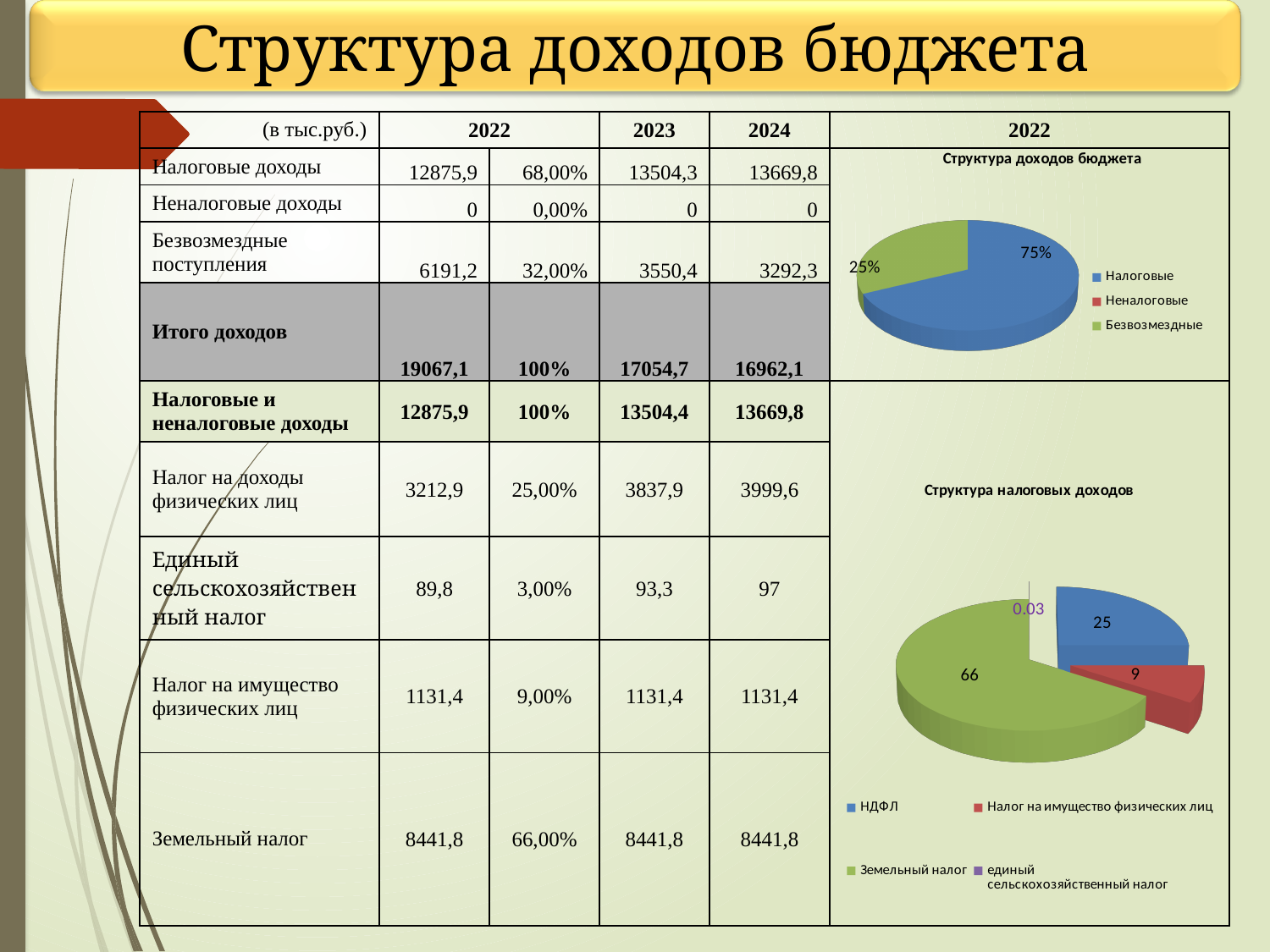
In the chart titled "Структура налоговых доходов", which is larger: НДФЛ or Налог на имущество физических лиц? НДФЛ In the chart titled "Структура налоговых доходов", what value is shown for единый сельскохозяйственный налог? 0.03 In the chart titled "Структура налоговых доходов", what is the difference between the values for Земельный налог and НДФЛ? 41 In the chart titled "Структура налоговых доходов", what value is shown for Налог на имущество физических лиц? 9 What kind of chart is the chart titled "Структура доходов бюджета"? Pie chart In the chart titled "Структура налоговых доходов", what value is shown for Земельный налог? 66 In the chart titled "Структура доходов бюджета", what share is shown for the Безвозмездные slice? 25% In the chart titled "Структура доходов бюджета", what share is shown for the Налоговые slice? 75% In the chart titled "Структура налоговых доходов", what value is shown for НДФЛ? 25 In the chart titled "Структура доходов бюджета", which category has the largest slice? Налоговые In the chart titled "Структура доходов бюджета", how many entries does the legend list? 3 In the chart titled "Структура налоговых доходов", which category has the largest slice? Земельный налог